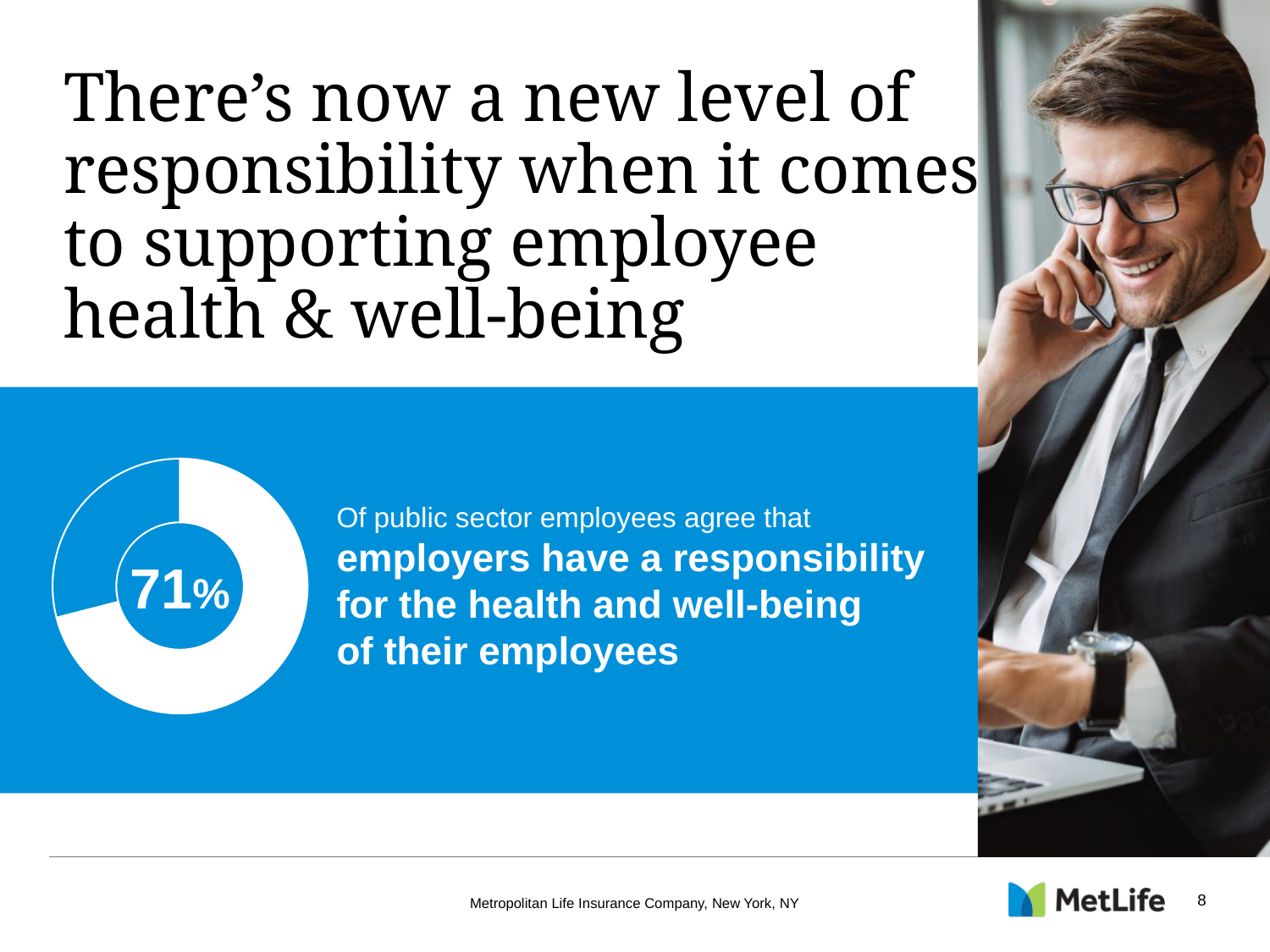
What percentage is printed in the centre of the donut chart? 71% Is the value shown in the donut chart greater or less than 50%? greater What kind of chart is shown on the slide? Donut chart What colour is the filled segment of the donut chart? White Which is larger in the donut chart: the filled white segment or the remaining blue segment? The filled white segment Which group of employees does the donut chart's statistic refer to? Public sector employees How many segments does the donut chart have? 2 What share of public sector employees agree that employers have a responsibility for the health and well-being of their employees, according to the chart? 71%